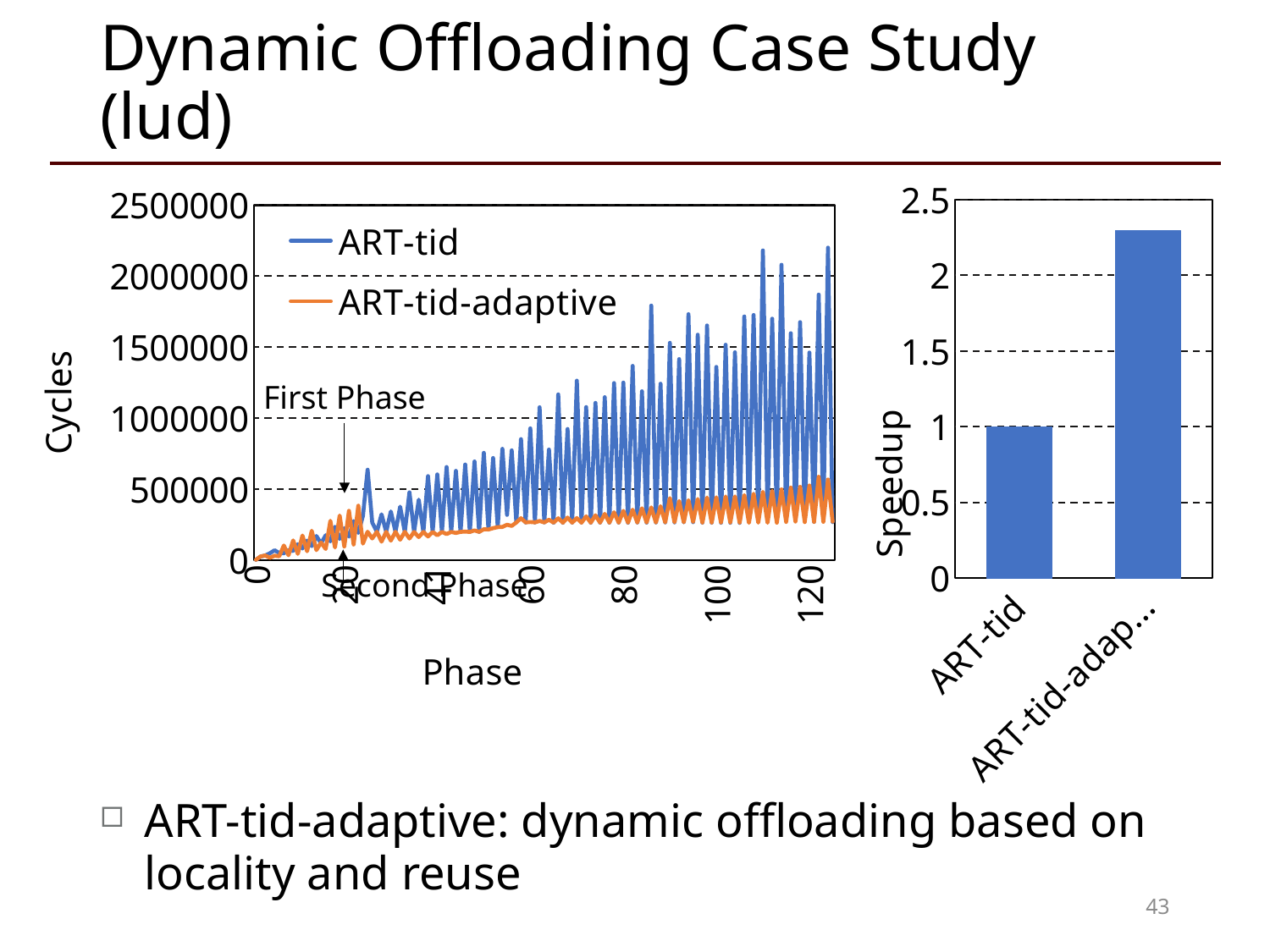
What kind of chart is the left chart on the slide? line chart What is the label of the y axis of the left line chart? Cycles In the left line chart, is the highest peak of the ART-tid series greater or less than 2000000 cycles? greater In the left line chart, which series has the higher cycle values in the later phases, ART-tid or ART-tid-adaptive? ART-tid In the right bar chart, which category has the higher speedup? ART-tid-adaptive In the right bar chart, which category has the lowest speedup? ART-tid What kind of chart is the right chart on the slide? bar chart In the right bar chart, is the speedup for the right-hand bar (ART-tid-adaptive) greater or less than 2? greater How many series does the legend of the left chart list? 2 In the right bar chart, what is the speedup value for ART-tid? 1 How many bars are plotted in the right bar chart? 2 In the left line chart, do the ART-tid cycle values generally rise or fall as the phase increases? rise